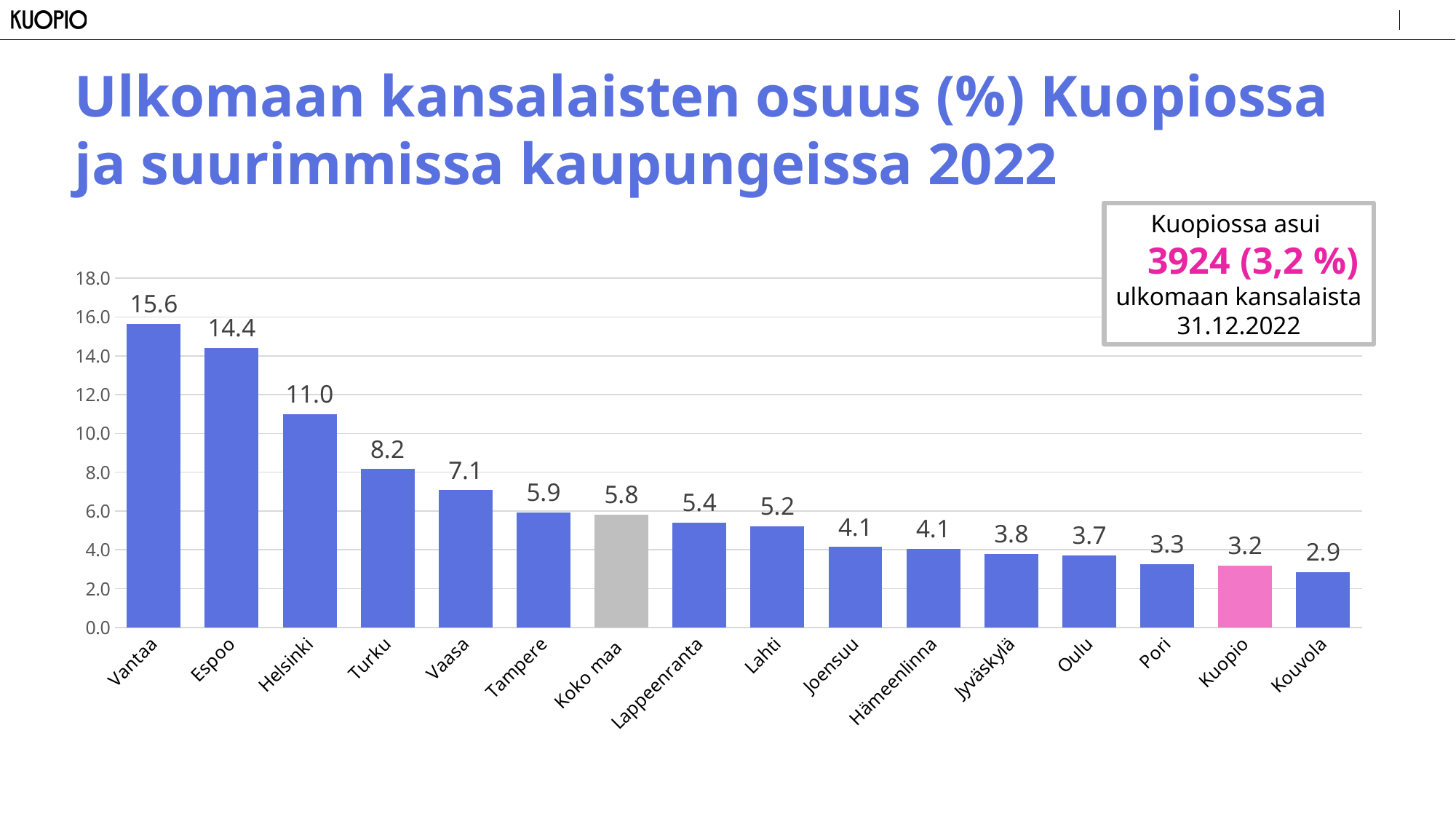
Which is larger, the value for Turku or the value for Vaasa? Turku What kind of chart is shown on the slide? bar chart What is the value for Vantaa? 15.6 Is the value for Tampere greater or less than 4.0? greater Which category has the lowest value? Kouvola Which bar is coloured pink? Kuopio How many categories are shown on the x axis? 16 What is the value for Koko maa? 5.8 Which category has the highest value? Vantaa Do the values rise or fall from left to right along the x axis? fall What is the difference between the values for Espoo and Helsinki? 3.4 What is the value for Kuopio? 3.2